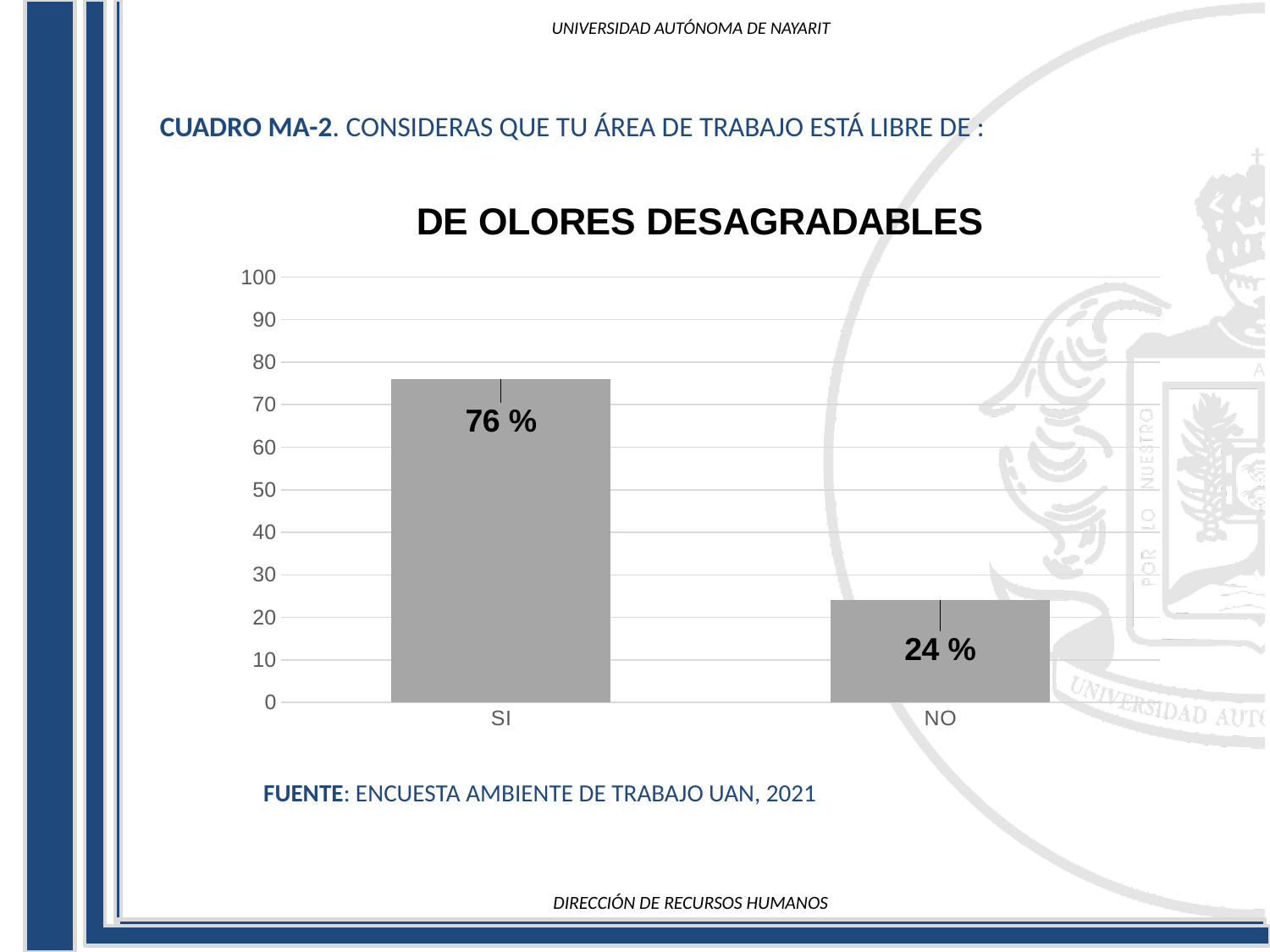
Which is larger, the value for SI or the value for NO? SI What is the title of the chart? DE OLORES DESAGRADABLES What kind of chart is shown? bar chart How many categories are shown on the x axis? 2 What is the difference between the values for SI and NO? 52 % What is the maximum value shown on the y axis? 100 Is the value for SI greater or less than 70? greater Is the value for NO greater or less than 30? less What is the value for SI? 76 % Which category has the highest value? SI What is the value for NO? 24 % Which category has the lowest value? NO